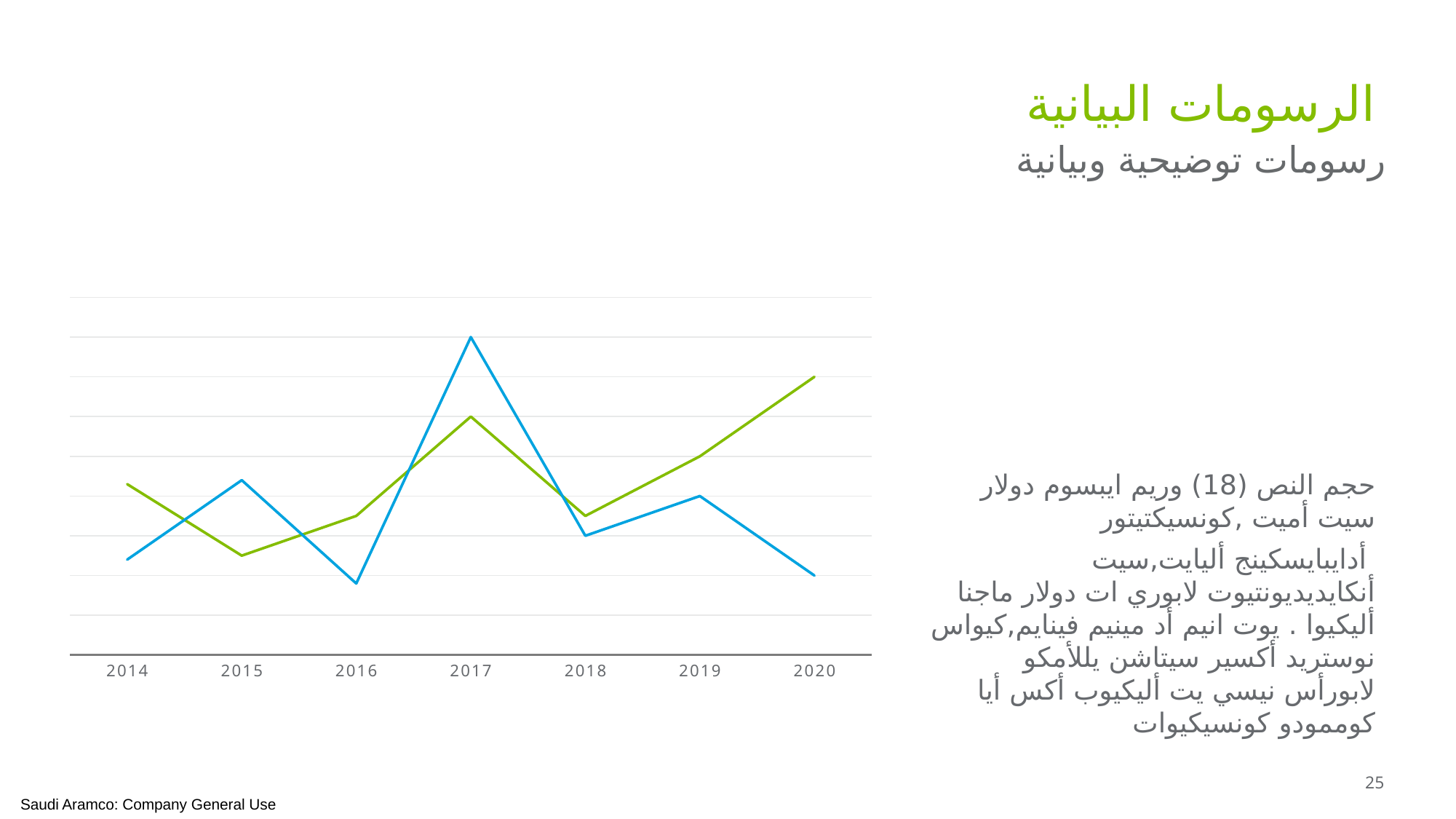
What kind of chart is shown on the slide? line chart How many years are shown on the x axis of the chart? 7 In which year does the green line reach its lowest point? 2015 What is the last year shown on the x axis of the chart? 2020 In 2017, which line is higher, the blue line or the green line? the blue line Does the green line rise or fall from 2018 to 2020? rise What is the first year shown on the x axis of the chart? 2014 In which year does the blue line reach its highest point? 2017 In 2015, which line is higher, the blue line or the green line? the blue line Does the blue line rise or fall from 2019 to 2020? fall In 2020, which line is higher, the blue line or the green line? the green line In which year does the green line reach its highest point? 2020